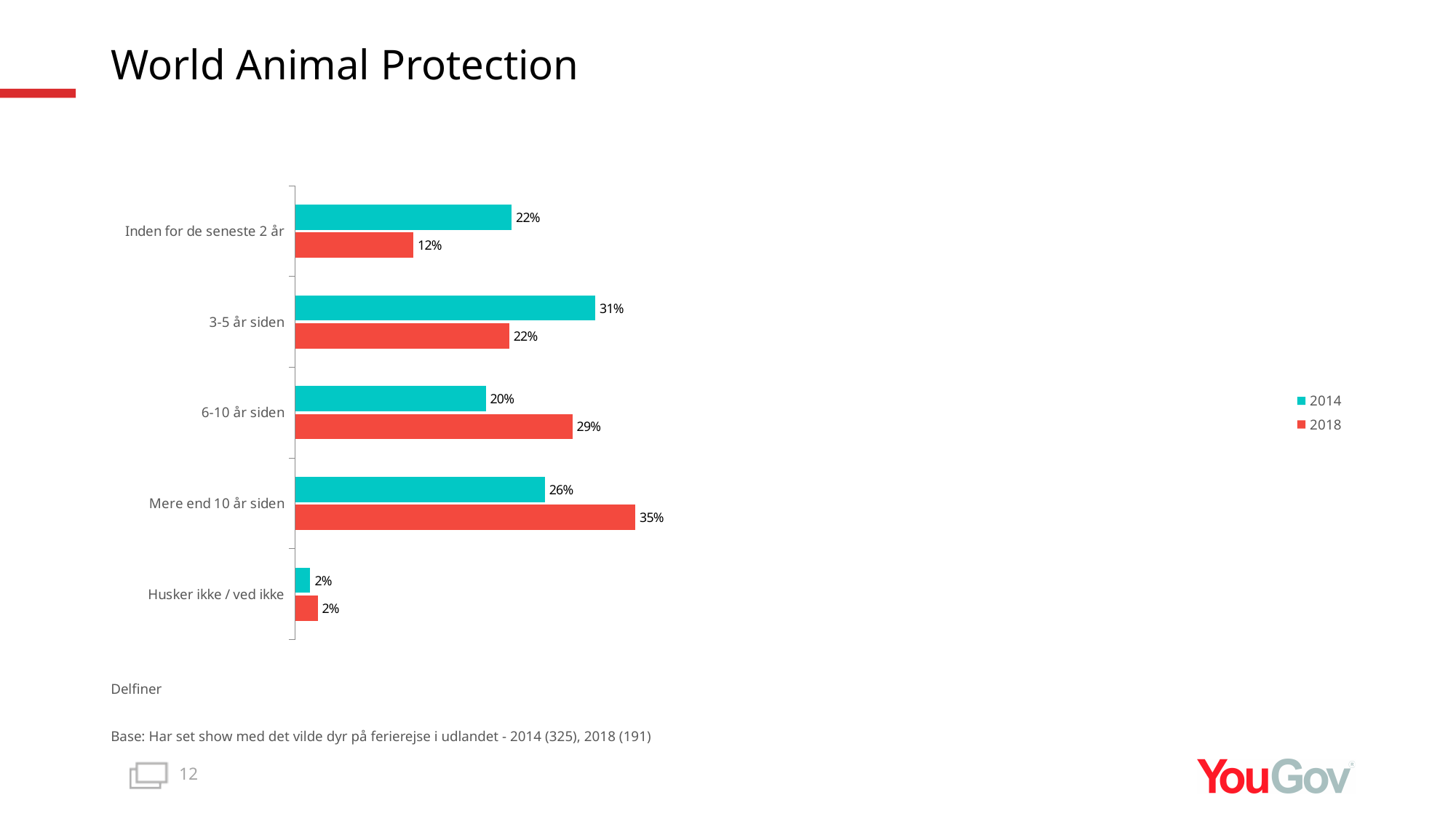
What is the difference between the 2014 and 2018 values for "3-5 år siden"? 9 percentage points What is the 2018 value for "Inden for de seneste 2 år"? 12% What is the 2018 value for "Mere end 10 år siden"? 35% How many series does the legend list? 2 Which category has the highest 2018 value? Mere end 10 år siden Which series is shown in red? 2018 For "Inden for de seneste 2 år", which year has the larger value, 2014 or 2018? 2014 How many categories are shown on the chart? 5 Which category has the lowest 2014 value? Husker ikke / ved ikke What is the difference between the 2014 and 2018 values for "6-10 år siden"? 9 percentage points What is the 2014 value for "3-5 år siden"? 31% What type of chart is shown on the slide? Bar chart